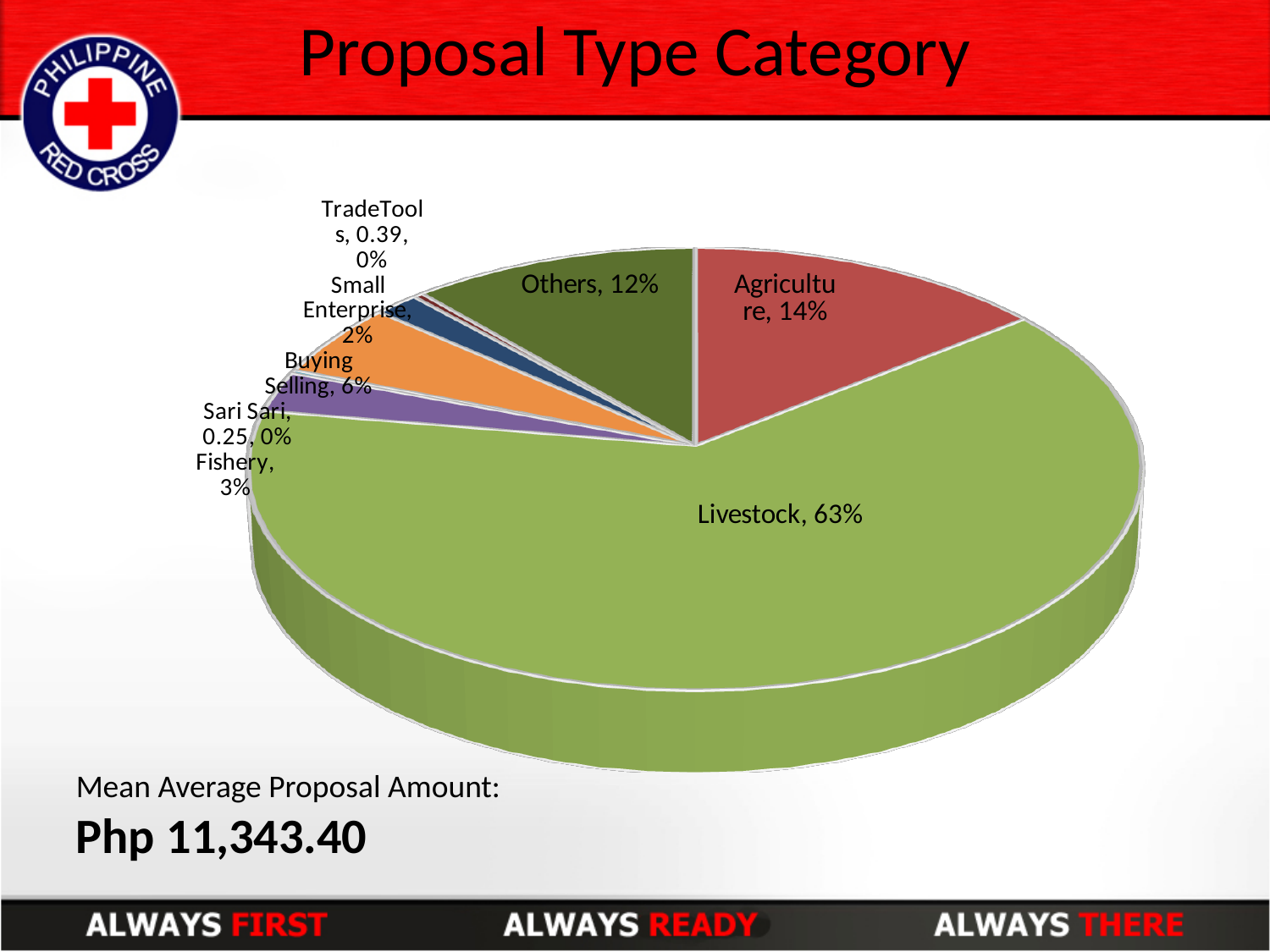
How many categories are shown in the pie chart? 8 Which is larger, the Agriculture slice or the Others slice? Agriculture What type of chart is shown on the slide? Pie chart What is the difference in percentage points between Livestock and Agriculture? 49 Which category has the largest slice of the pie? Livestock What percentage is shown for Agriculture? 14% What is the title of the chart? Proposal Type Category What percentage is shown for Buying Selling? 6% What percentage is shown for Fishery? 3% What percentage is shown for Others? 12% What share of the pie does Livestock account for? 63% What percentage is shown for Small Enterprise? 2%